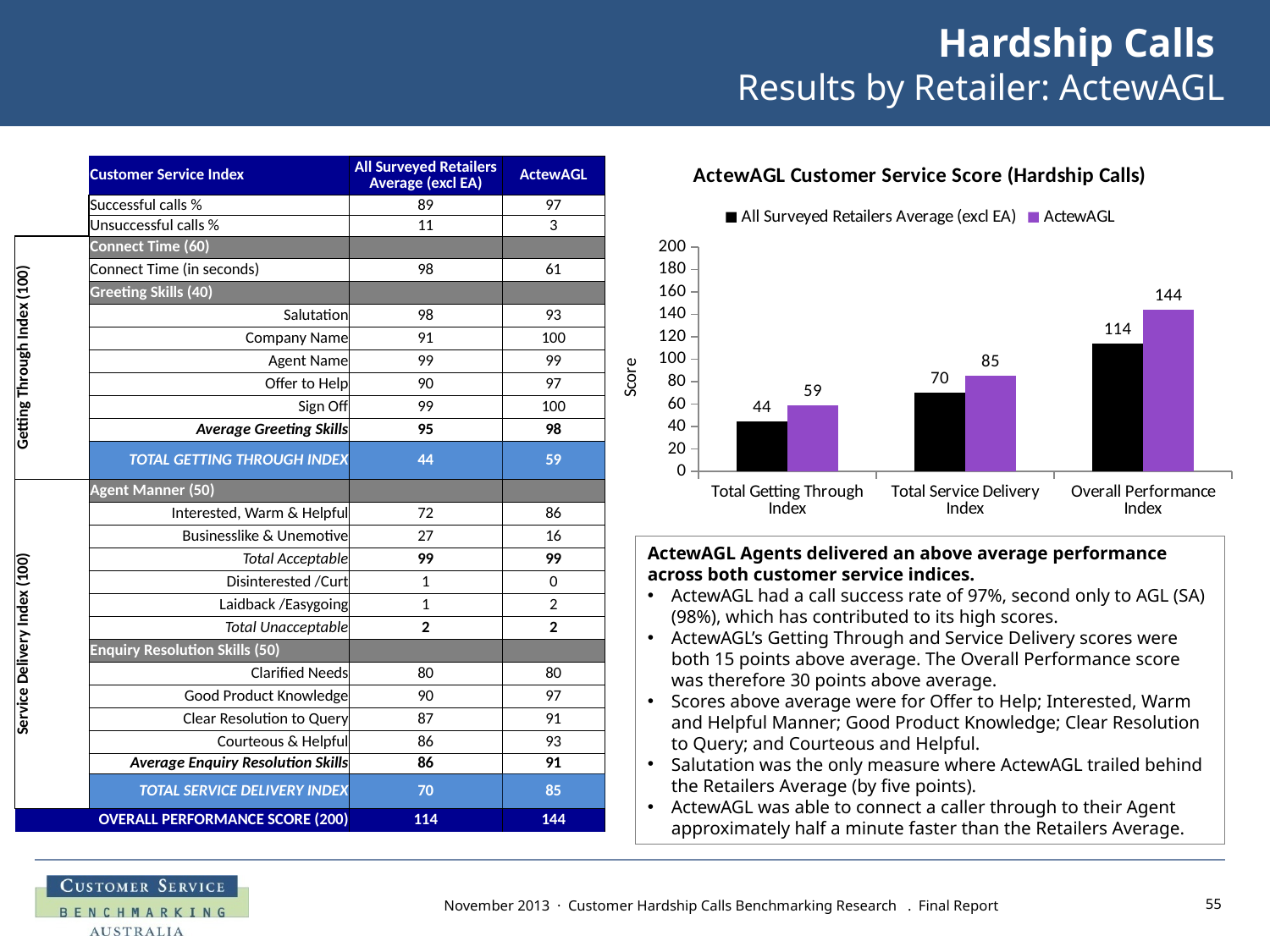
Is the All Surveyed Retailers Average (excl EA) value for Overall Performance Index greater or less than 100? greater How many categories are shown on the x axis? 3 What is the ActewAGL value for Total Getting Through Index? 59 Which category has the highest ActewAGL value? Overall Performance Index What is the ActewAGL value for Overall Performance Index? 144 What is the All Surveyed Retailers Average (excl EA) value for Total Service Delivery Index? 70 What kind of chart is shown? bar chart Which is larger for Total Service Delivery Index: ActewAGL or All Surveyed Retailers Average (excl EA)? ActewAGL How many series does the legend list? 2 Which category has the lowest All Surveyed Retailers Average (excl EA) value? Total Getting Through Index What is the difference between the ActewAGL and All Surveyed Retailers Average (excl EA) values for Overall Performance Index? 30 What is the title of the chart? ActewAGL Customer Service Score (Hardship Calls)